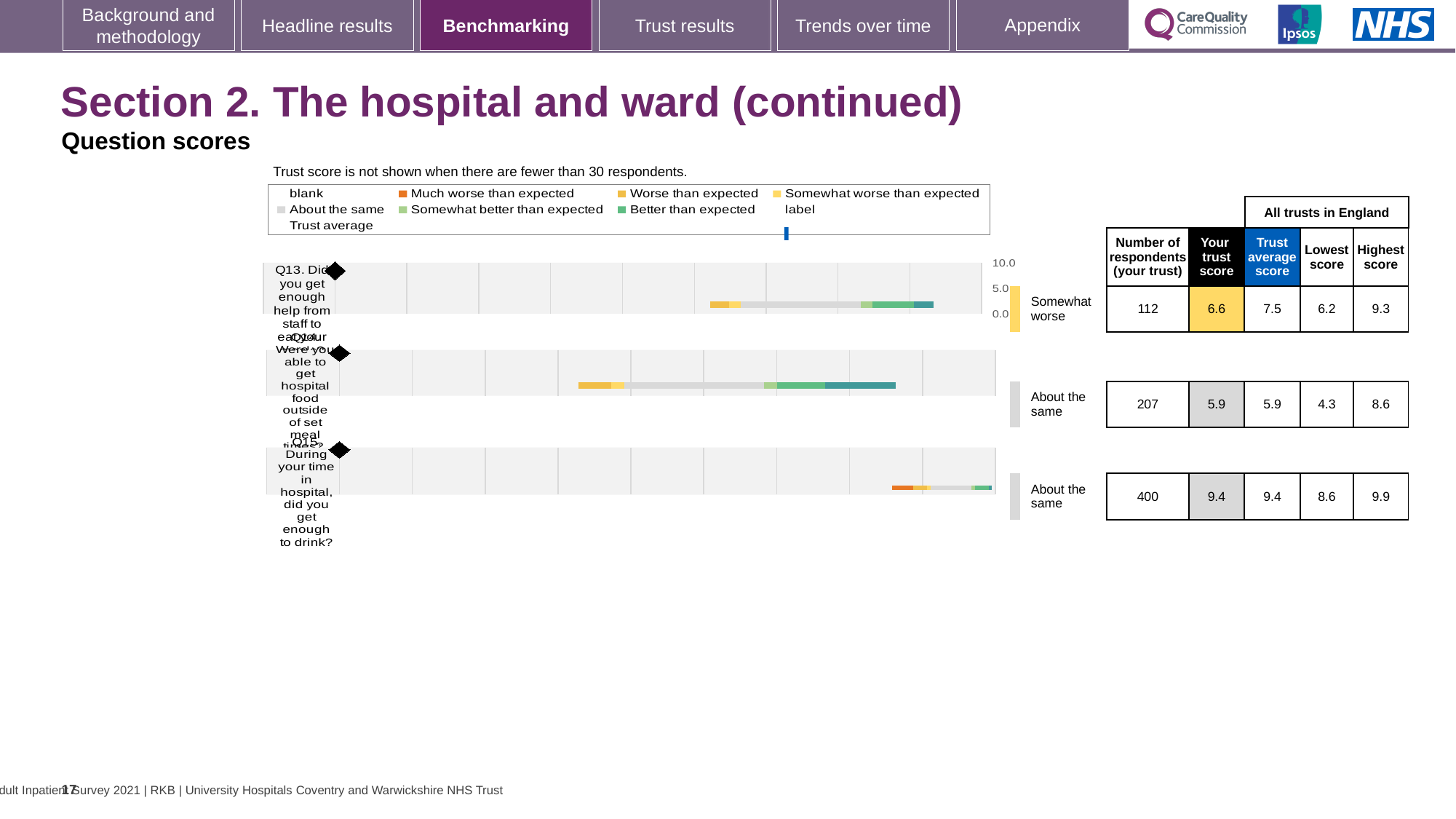
What is the lowest score across all trusts in England for Q14? 4.3 Which question has the lowest trust score? Q14 Which question has the highest trust score? Q15 What benchmark category is shown for Q13? Somewhat worse How many respondents answered Q14 (Were you able to get hospital food outside of set meal times?)? 207 How many survey questions are plotted in the benchmarking chart? 3 What is the difference between the highest and lowest scores for Q15? 1.3 What is the trust score for Q13 (Did you get enough help from staff to eat your meals?)? 6.6 What kind of chart is used to show the question scores? bar chart What is the highest score across all trusts in England for Q15 (did you get enough to drink?)? 9.9 For Q13, which is larger: the trust score or the trust average score? Trust average score What is the difference between the trust average score and the trust score for Q13? 0.9